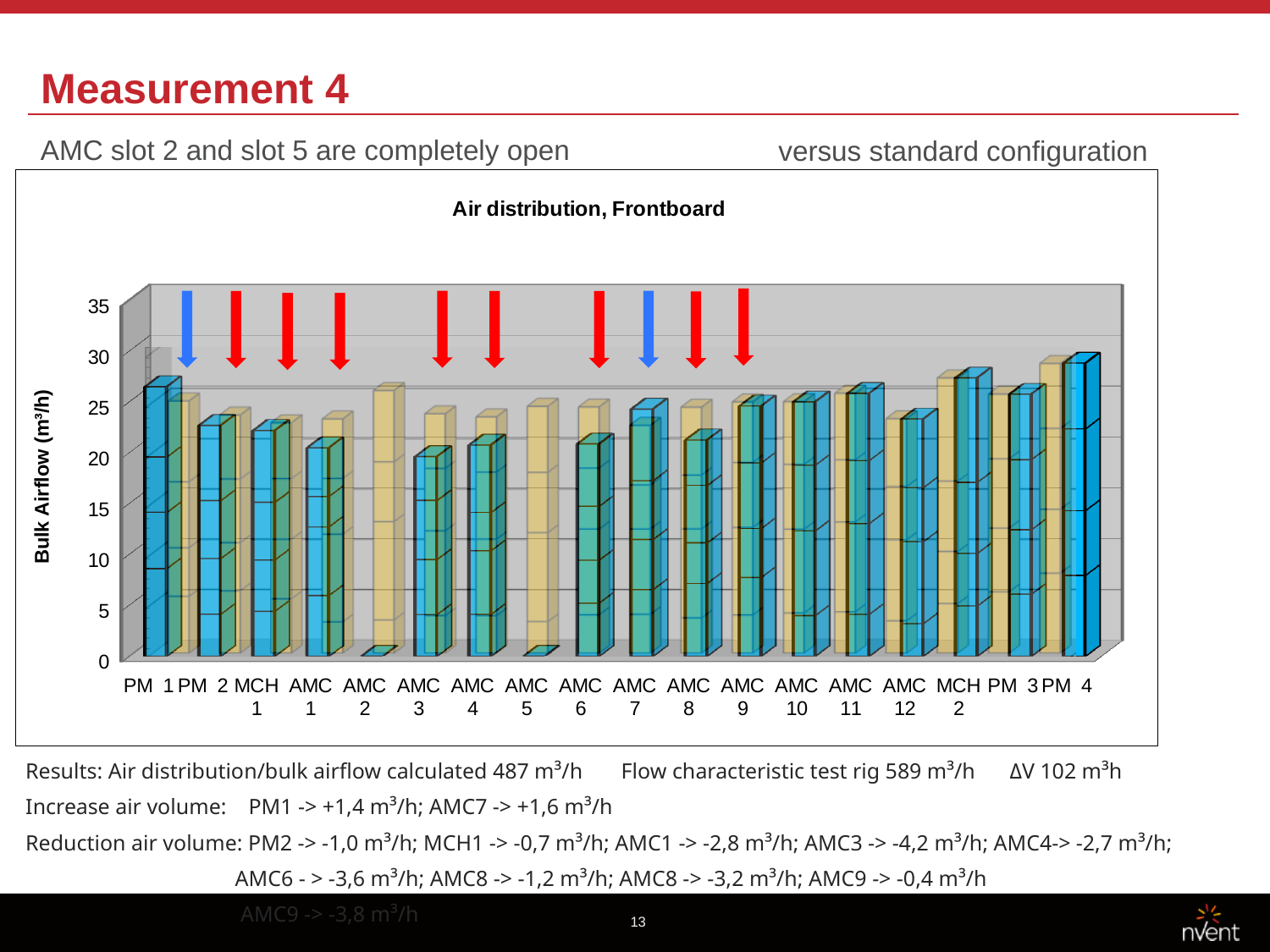
Is the blue bar for PM 1 greater or less than 20? greater Is the blue bar for PM 4 greater or less than 25? greater Is the blue bar for AMC 2 greater or less than 5? less Which category has the tallest blue bar? PM 4 What is the title of the chart? Air distribution, Frontboard Which has the taller blue bar, PM 4 or AMC 3? PM 4 What kind of chart is shown on the slide? bar chart What is the label of the vertical axis? Bulk Airflow (m³/h) Which has the taller blue bar, MCH 2 or AMC 1? MCH 2 How many categories are shown along the x axis of the chart? 18